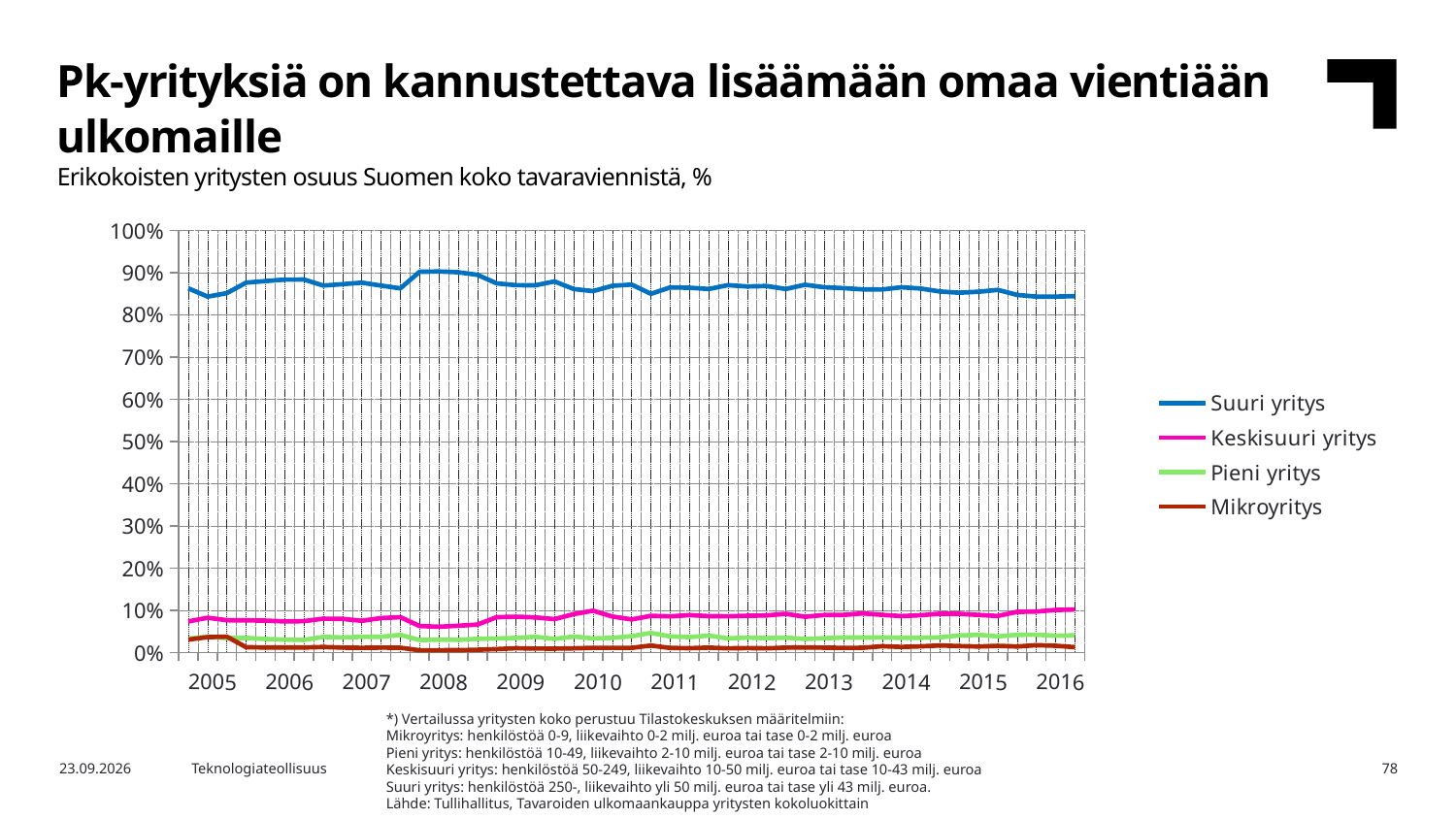
Which is larger in 2010, the value for Pieni yritys or the value for Mikroyritys? Pieni yritys Is the value for Keskisuuri yritys in 2016 greater or less than 20%? less How many years are labeled on the x axis of the chart? 12 Which is larger in 2014, the value for Keskisuuri yritys or the value for Pieni yritys? Keskisuuri yritys Is the value for Suuri yritys in 2008 greater or less than 80%? greater What colour is the line for Suuri yritys in the chart? Blue What kind of chart is shown on the slide? Line chart Which series has the highest share of Finland's goods exports throughout the chart? Suuri yritys How many series does the legend list? 4 Is the value for Pieni yritys in 2012 greater or less than 10%? less Does the Keskisuuri yritys line end higher or lower in 2016 than it started in 2005? Higher